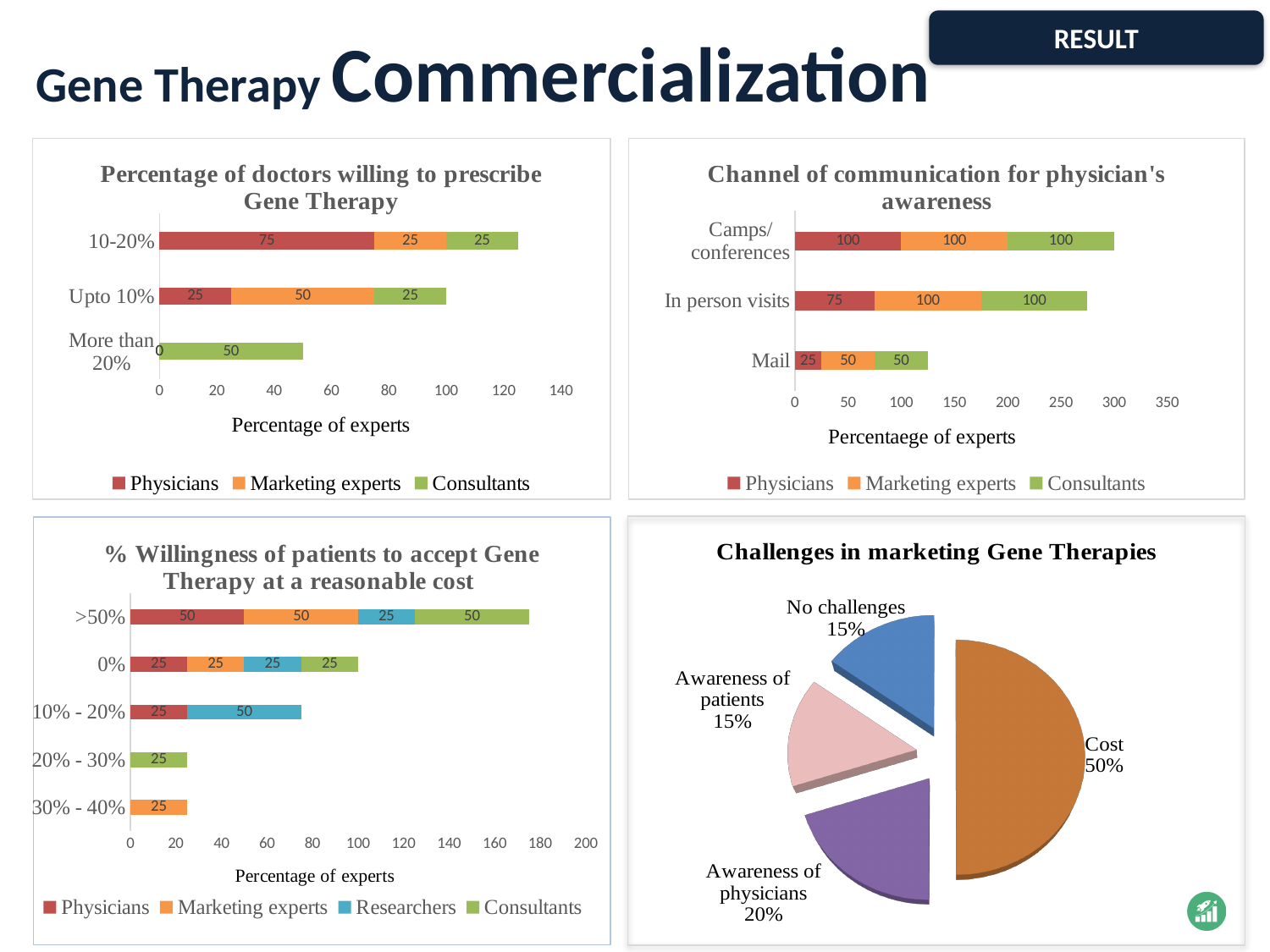
In the 'Percentage of doctors willing to prescribe Gene Therapy' chart, how many series does the legend list? 3 In the '% Willingness of patients to accept Gene Therapy at a reasonable cost' chart, how many categories are shown on the vertical axis? 5 In the 'Challenges in marketing Gene Therapies' pie chart, what share does 'Awareness of physicians' have? 20% In the '% Willingness of patients to accept Gene Therapy at a reasonable cost' chart, what is the value for Researchers in the '>50%' category? 25 What kind of chart is 'Challenges in marketing Gene Therapies'? Pie chart In the 'Channel of communication for physician's awareness' chart, what is the difference between the Marketing experts value for 'Camps/conferences' and for 'Mail'? 50 In the 'Channel of communication for physician's awareness' chart, what is the total of the stacked bar for 'Camps/conferences'? 300 In the 'Channel of communication for physician's awareness' chart, which channel has the lowest total? Mail In the 'Percentage of doctors willing to prescribe Gene Therapy' chart, what is the value for Physicians in the 10-20% category? 75 In the 'Channel of communication for physician's awareness' chart, what is the value for Physicians for 'In person visits'? 75 In the '% Willingness of patients to accept Gene Therapy at a reasonable cost' chart, what is the total of the stacked bar for '>50%'? 175 In the 'Percentage of doctors willing to prescribe Gene Therapy' chart, what is the total of the stacked bar for 'Upto 10%'? 100